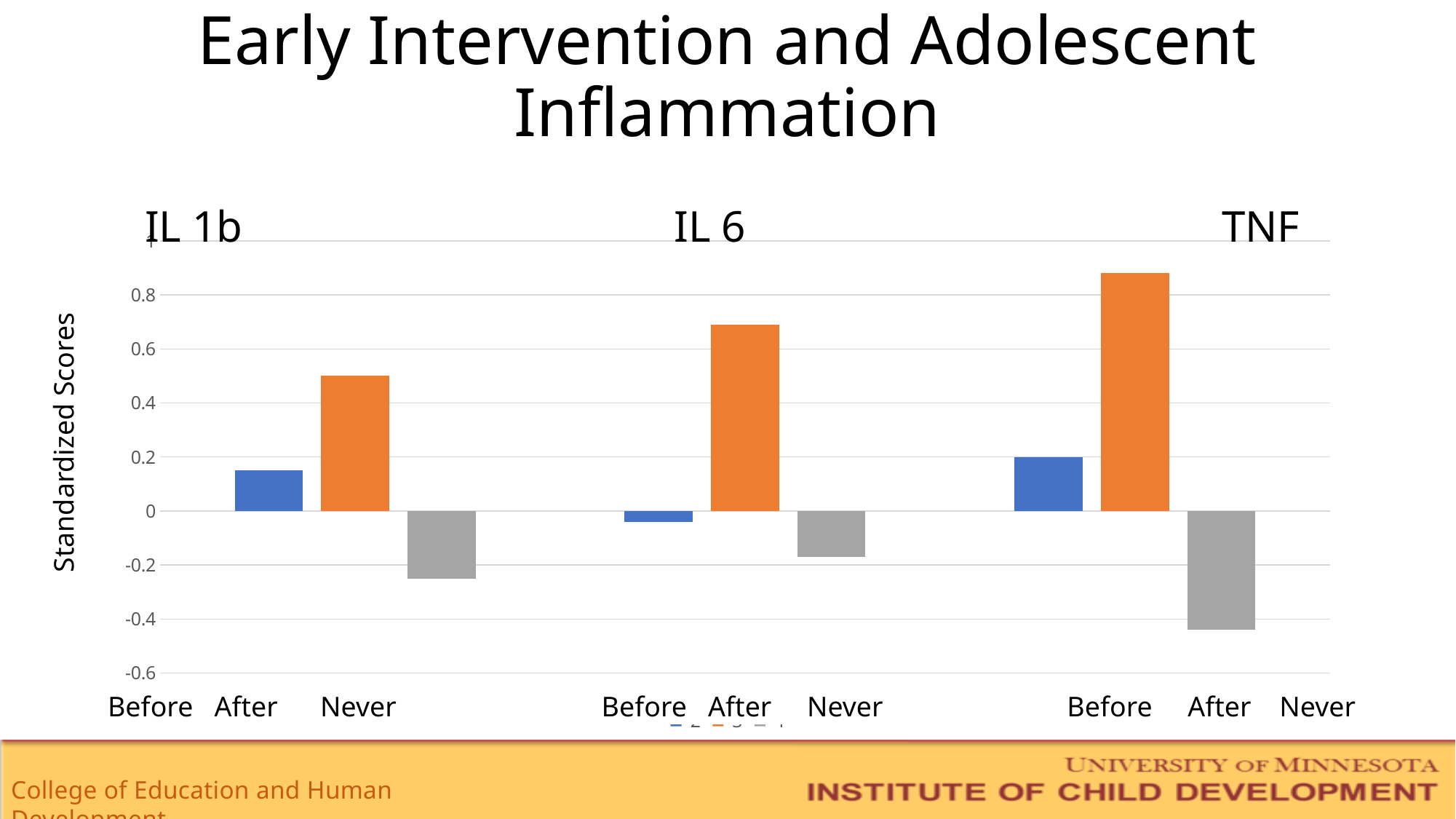
Which is larger, the After value for IL 6 or the After value for IL 1b? IL 6 Is the value for After in IL 1b greater or less than 0.4? greater Within the IL 6 group, which condition has the highest standardized score? After Is the value for After in TNF greater or less than 0.8? greater Which bar has the lowest value on the chart? Never in TNF Is the value for Never in IL 1b greater or less than 0? less Which bar has the highest value on the chart? After in TNF Which is larger, the Before value for IL 1b or the Before value for IL 6? IL 1b What kind of chart is shown on the slide? bar chart What is the label on the vertical axis? Standardized Scores How many inflammation markers (groups) are shown on the x axis? 3